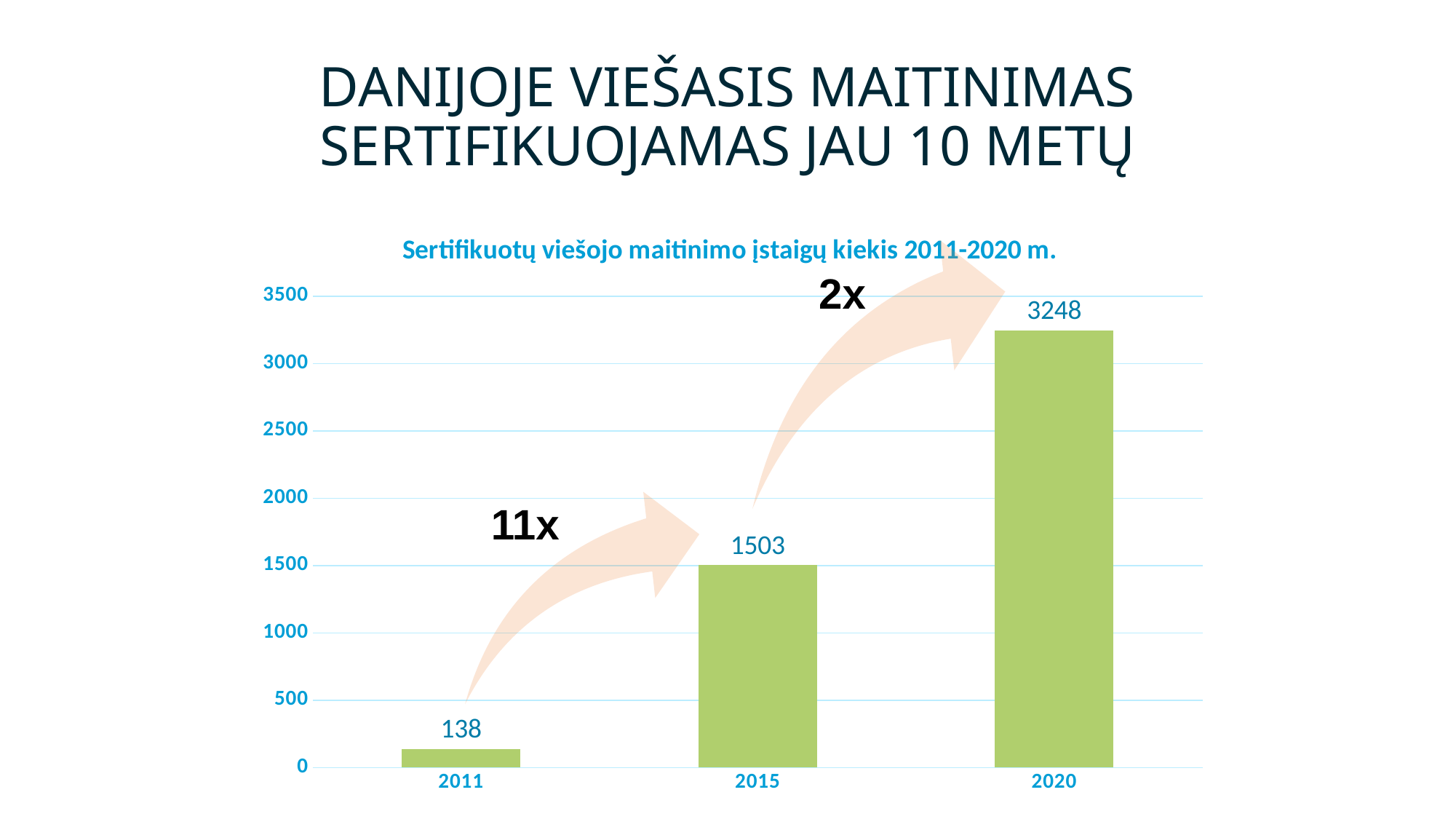
What is the value for 2015? 1503 What is the difference between the values for 2015 and 2011? 1365 Is the value for 2020 greater or less than 3000? greater Which is larger, the value for 2015 or the value for 2011? 2015 How many years are shown on the x axis? 3 What kind of chart is shown? bar chart Which year has the lowest value? 2011 What is the difference between the values for 2020 and 2015? 1745 What is the value for 2011? 138 What is the value for 2020? 3248 Which year has the highest value? 2020 Do the values rise or fall from 2011 to 2020? rise